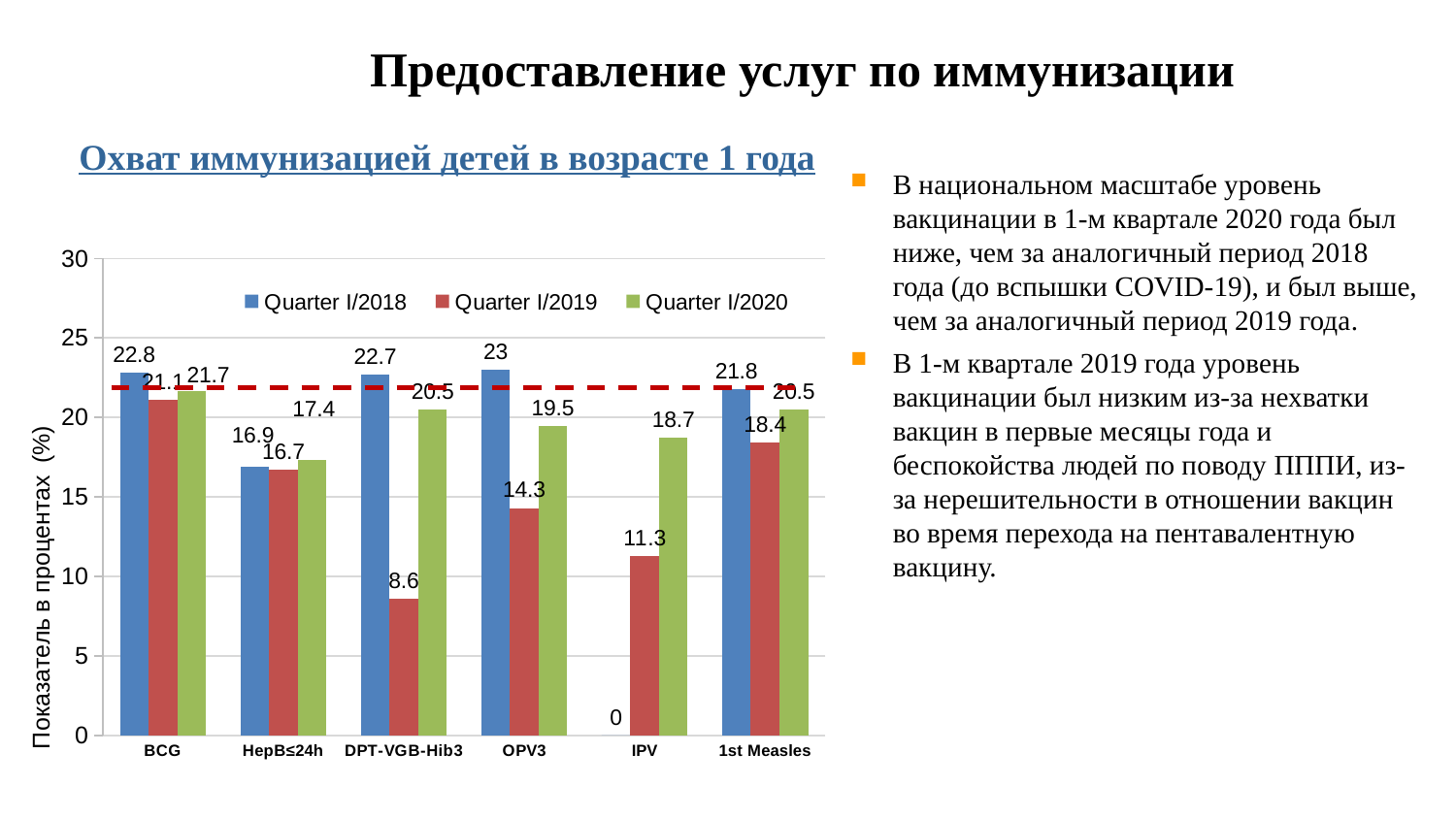
What is the Quarter I/2019 value for DPT-VGB-Hib3? 8.6 How many vaccine categories are shown on the x axis? 6 What is the Quarter I/2018 value for IPV? 0 What is the difference between the Quarter I/2018 and Quarter I/2019 values for OPV3? 8.7 What is the label of the y axis? Показатель в процентах (%) Which vaccine has the lowest Quarter I/2019 value? DPT-VGB-Hib3 What kind of chart is shown on the slide? Bar chart For HepB≤24h, which is larger: the Quarter I/2018 value or the Quarter I/2020 value? Quarter I/2020 What is the Quarter I/2020 value for IPV? 18.7 Which vaccine has the highest Quarter I/2018 value? OPV3 How many series does the legend list? 3 What is the Quarter I/2018 value for OPV3? 23